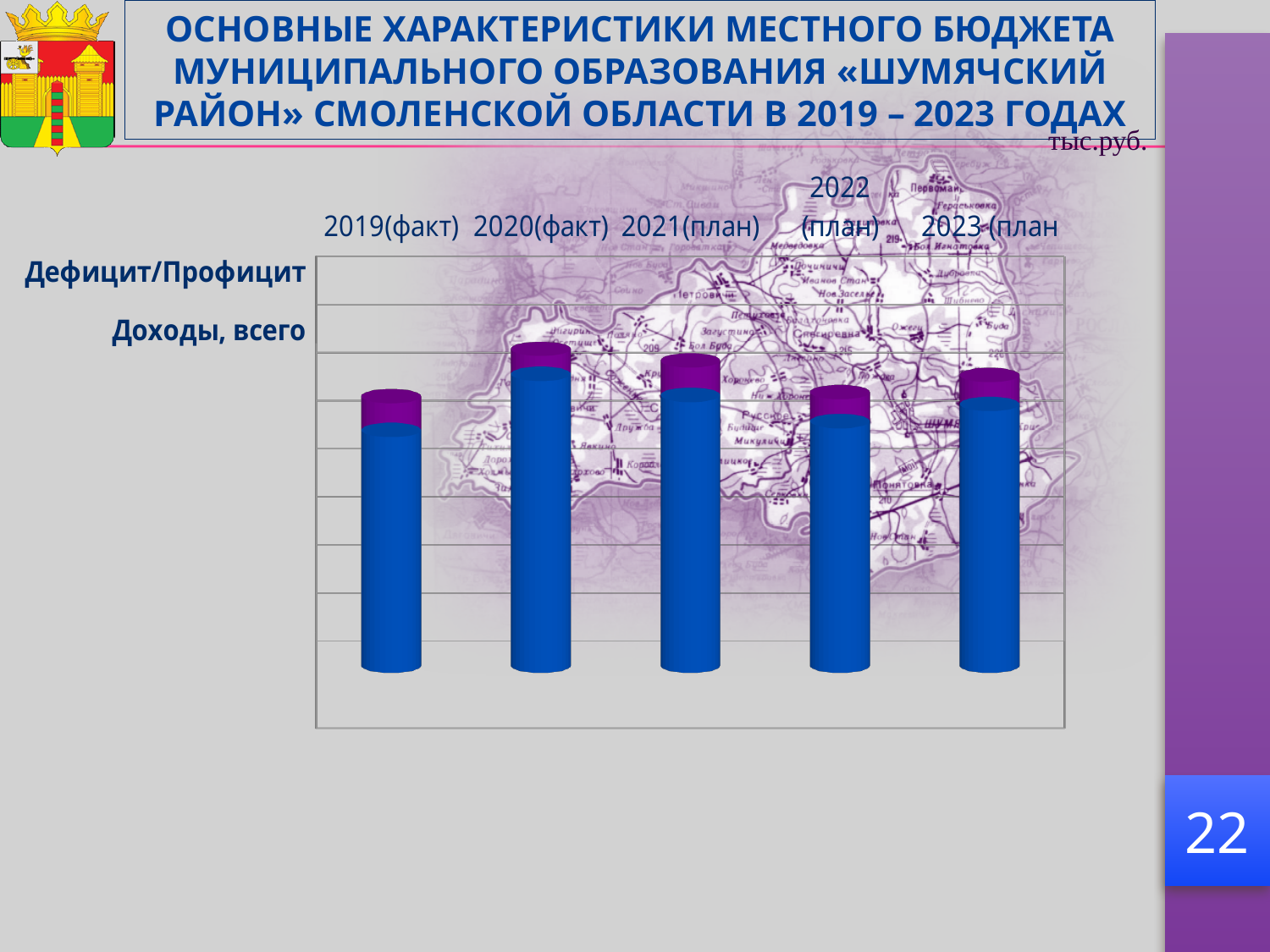
How many year categories are shown on the x axis of the chart? 5 Which bar is taller, 2019(факт) or 2020(факт)? 2020(факт) Which bar is taller, 2021(план) or 2019(факт)? 2021(план) Which bar is taller, 2020(факт) or 2022 (план)? 2020(факт) What unit of measurement is indicated for the chart? тыс.руб. Which years are labelled as (факт) on the x axis? 2019 and 2020 What kind of chart is shown on the slide? bar chart Which year category has the tallest bar in the chart? 2020(факт)